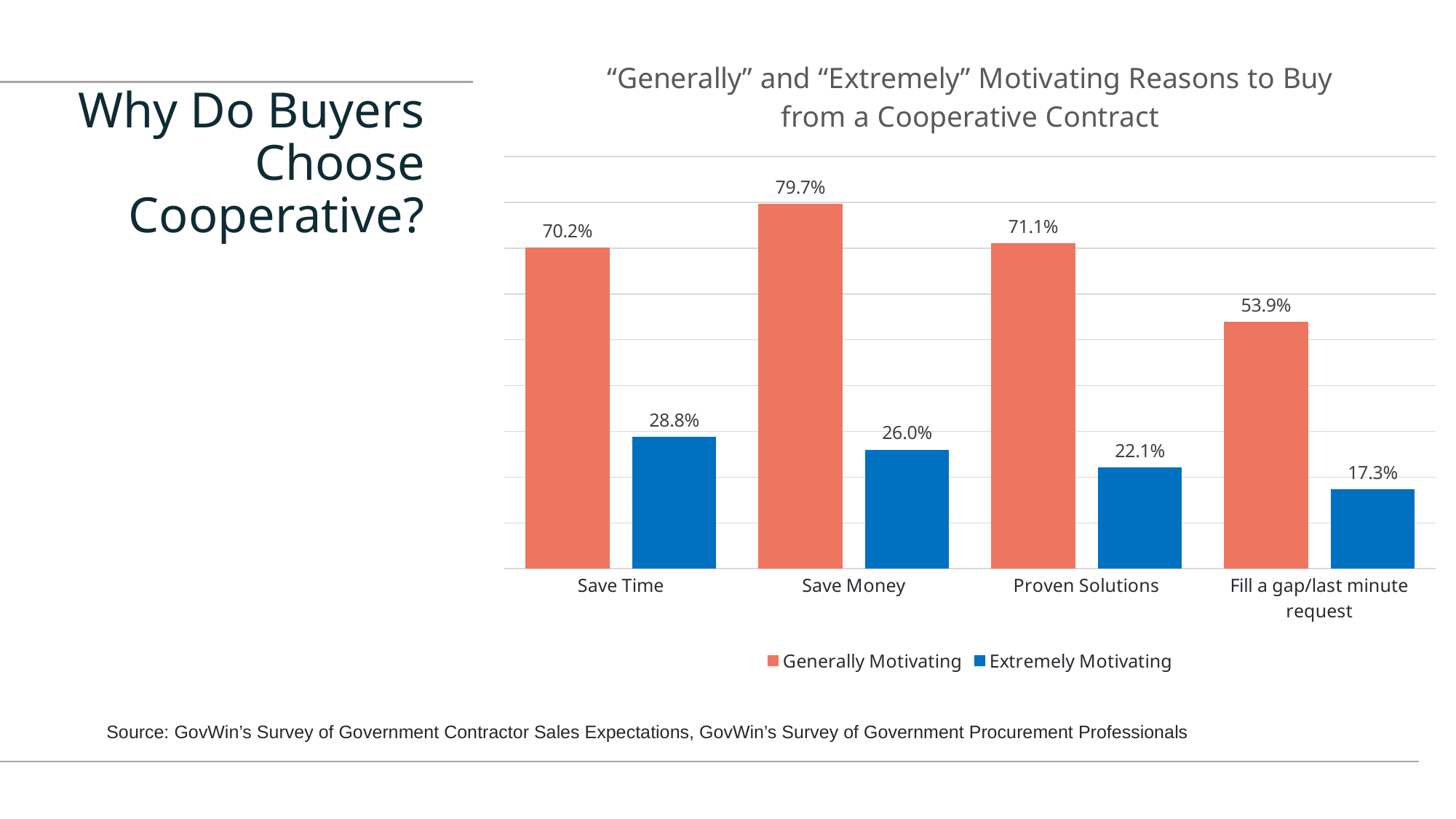
Which category has the lowest Extremely Motivating value? Fill a gap/last minute request Which category has the highest Generally Motivating value? Save Money What is the Generally Motivating value for Save Money? 79.7% What is the Extremely Motivating value for Fill a gap/last minute request? 17.3% Which colour represents the Extremely Motivating series? Blue What is the title of the chart? "Generally" and "Extremely" Motivating Reasons to Buy from a Cooperative Contract What is the difference between the Generally Motivating and Extremely Motivating values for Save Time? 41.4% How many series does the legend list? 2 What is the Extremely Motivating value for Proven Solutions? 22.1% Which is larger: the Extremely Motivating value for Save Time or for Save Money? Save Time How many categories are shown on the x axis? 4 What kind of chart is shown on the slide? Bar chart